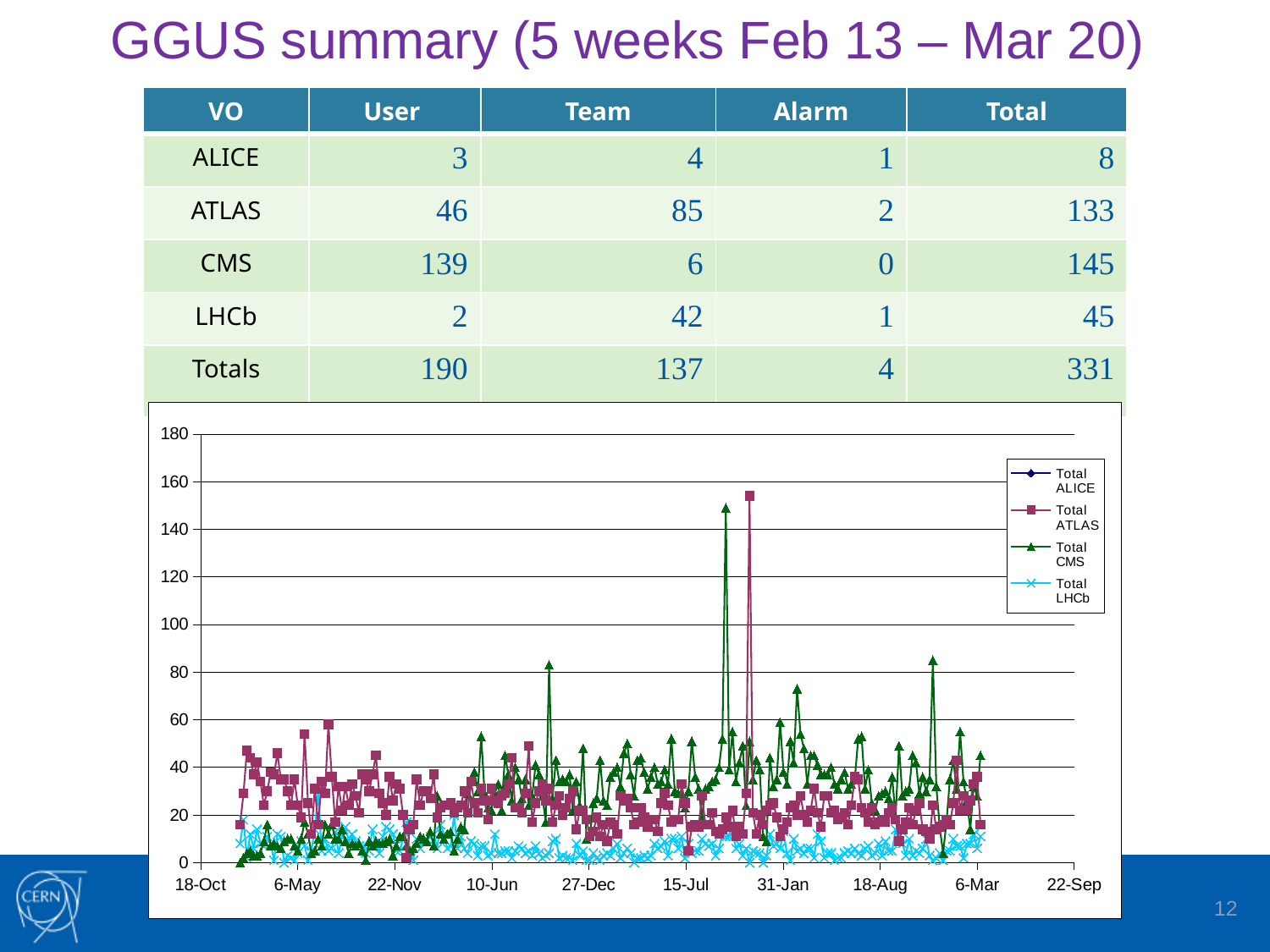
Is the highest value of the Total LHCb series greater or less than 40? less What kind of chart is shown below the table? line chart Which series are listed in the chart's legend? Total ALICE, Total ATLAS, Total CMS, Total LHCb How many series does the chart's legend list? 4 Is the Total ATLAS value at its peak greater or less than the Total LHCb value at the same point? greater Is the highest peak of the Total ATLAS series greater or less than 140? greater What is the highest value shown on the chart's y axis? 180 Is the highest peak of the Total CMS series greater or less than 120? greater How many date labels are shown on the chart's x axis? 10 What is the first date label on the chart's x axis? 18-Oct